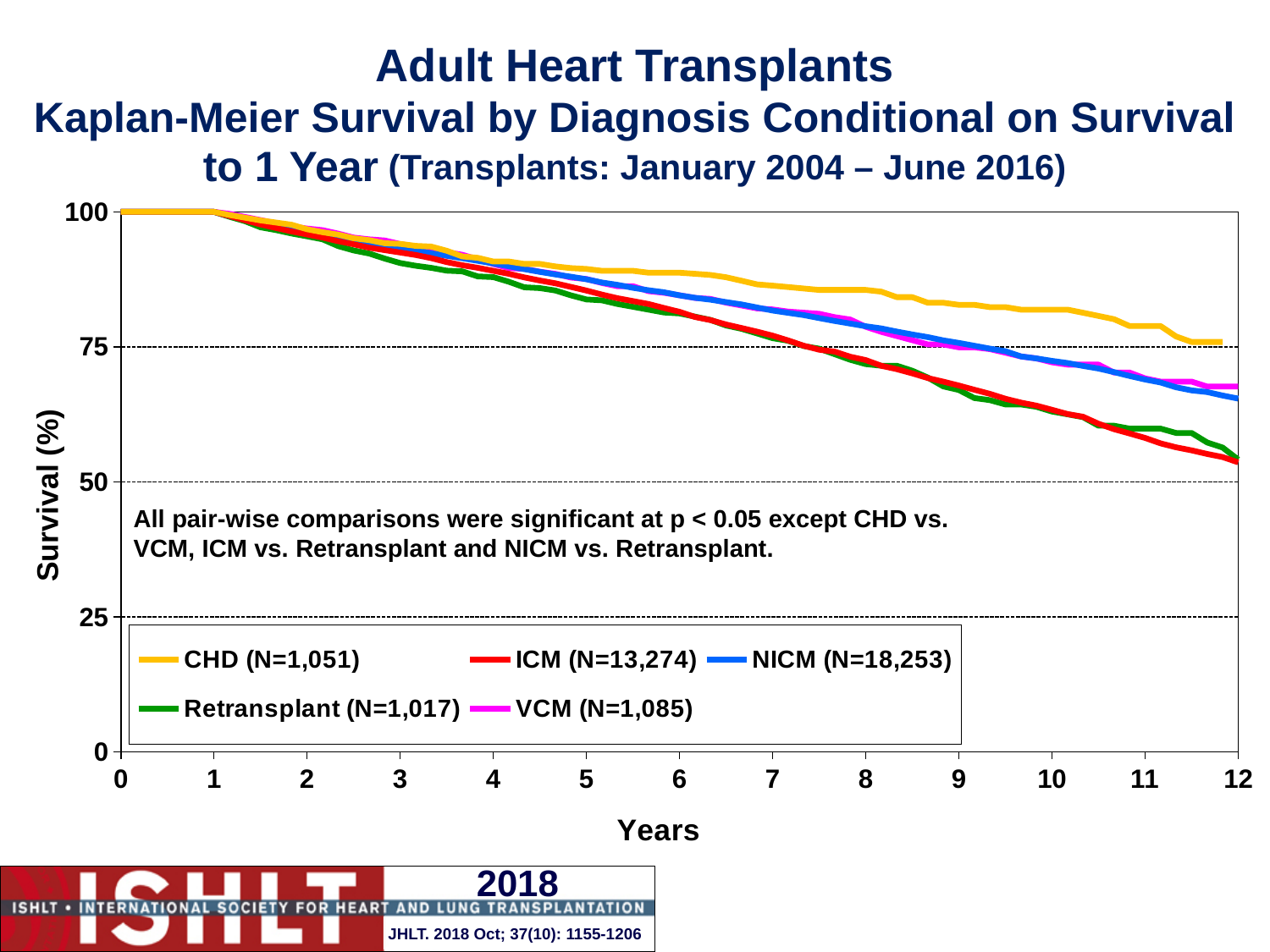
Is the survival value for Retransplant at 12 years greater or less than 75? less How many series does the legend list? 5 What kind of chart is shown on the slide? line chart At 10 years, which group has higher survival, CHD or ICM? CHD Is the survival value for CHD at 6 years greater or less than 75? greater At 8 years, which group has higher survival, NICM or ICM? NICM Do the survival values rise or fall as years increase along the x axis? fall According to the legend, what is the N for the ICM group? 13,274 Is the survival value for NICM at 12 years greater or less than 50? greater What is the survival value for all groups at 0 years? 100 Which diagnosis group has the highest survival at 12 years? CHD